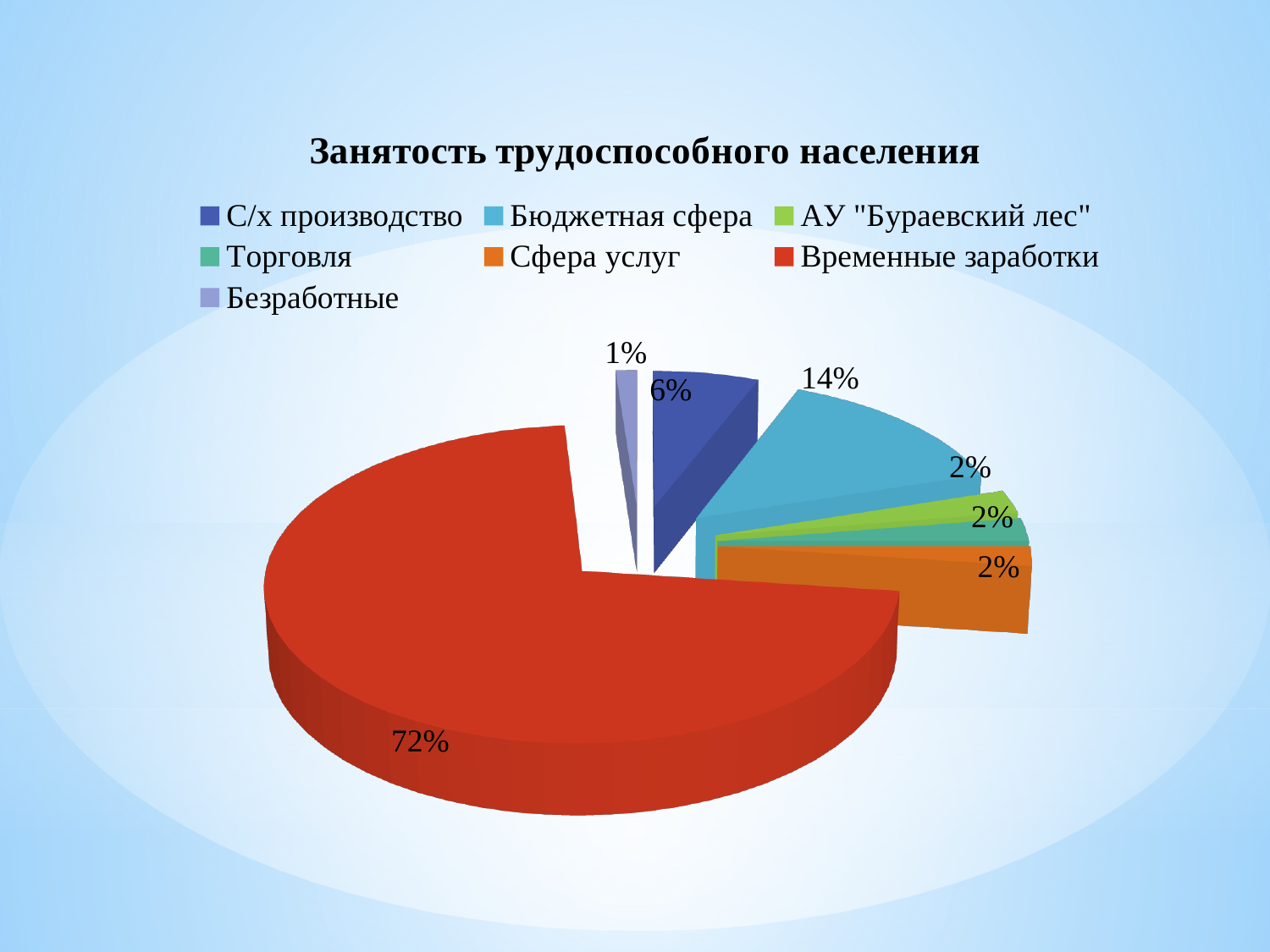
What is the difference between the shares of Бюджетная сфера and С/х производство? 8% What share of the pie is С/х производство? 6% What share of the pie is Временные заработки? 72% Which is larger, the share of Бюджетная сфера or the share of С/х производство? Бюджетная сфера What is the title of the chart? Занятость трудоспособного населения What share of the pie is Бюджетная сфера? 14% Which category has the largest share of the pie? Временные заработки How many categories does the legend list? 7 What share of the pie is Сфера услуг? 2% What type of chart is shown on the slide? Pie chart Which category has the smallest share of the pie? Безработные What share of the pie is Безработные? 1%